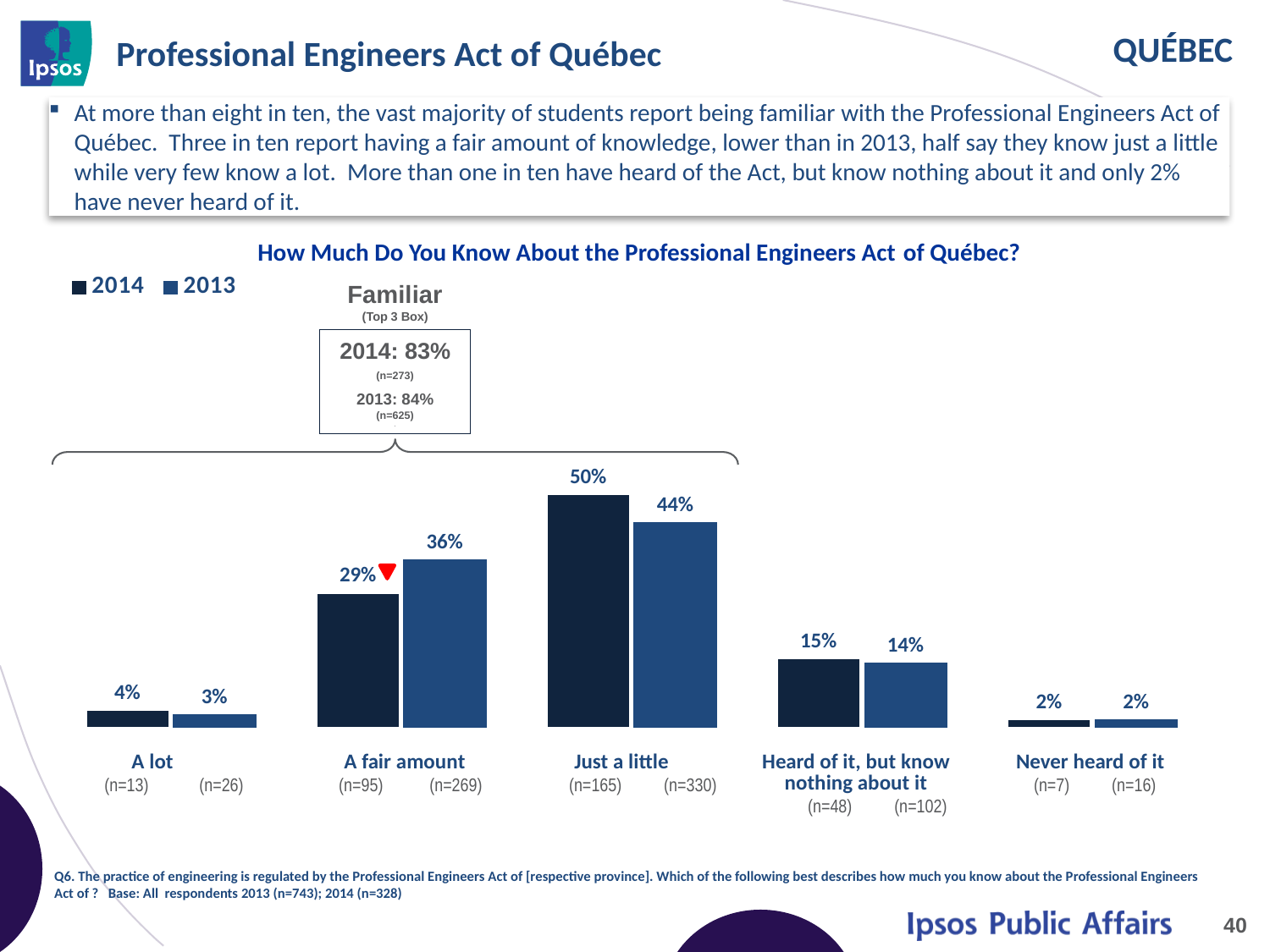
What type of chart is used to show how much students know about the Act? Bar chart How many series does the legend list? 2 Which category has the highest value for 2014? Just a little How many response categories are shown on the x axis of the chart? 5 What percentage of students in 2013 said they know 'A fair amount' about the Act? 36% Which category has the lowest value for 2013? Never heard of it What percentage of students in 2014 said they had 'Never heard of it'? 2% Which is larger for 'Heard of it, but know nothing about it': the 2014 value or the 2013 value? 2014 What percentage of students in 2014 said they know 'Just a little' about the Professional Engineers Act of Québec? 50% What is the 2014 'Familiar (Top 3 Box)' percentage shown in the box above the chart? 83% What is the difference between the 2014 and 2013 values for 'Just a little'? 6% What is the difference between the 2013 and 2014 values for 'A fair amount'? 7%